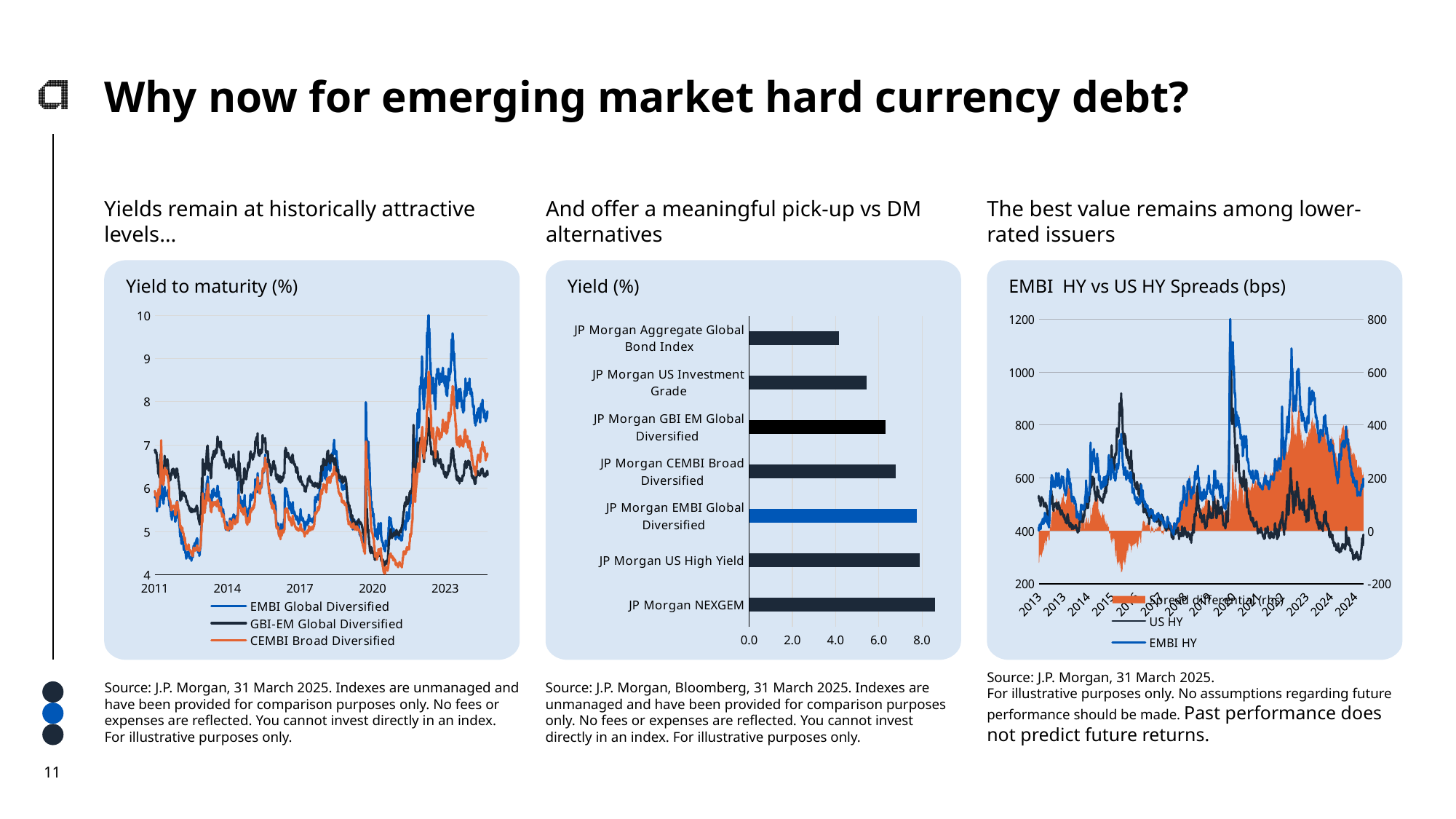
In the "Yield (%)" bar chart, how many indexes are plotted? 7 In the "Yield (%)" bar chart, which has the larger yield: JP Morgan NEXGEM or JP Morgan CEMBI Broad Diversified? JP Morgan NEXGEM How many series does the legend of the "EMBI HY vs US HY Spreads (bps)" chart list? 3 In the "Yield (%)" bar chart, which index has the lowest yield? JP Morgan Aggregate Global Bond Index In the "Yield (%)" bar chart, is the value for JP Morgan US Investment Grade greater or less than 4.0? greater How many series does the legend of the "Yield to maturity (%)" chart list? 3 In the "Yield (%)" bar chart, is the value for JP Morgan Aggregate Global Bond Index greater or less than 6.0? less What kind of chart is the "Yield to maturity (%)" chart on the left of the slide? line chart What kind of chart is the "Yield (%)" chart in the middle of the slide? bar chart In the "Yield (%)" bar chart, is the value for JP Morgan NEXGEM greater or less than 8.0? greater In the "Yield to maturity (%)" chart, which series is drawn in orange? CEMBI Broad Diversified In the "Yield (%)" bar chart, which index has the highest yield? JP Morgan NEXGEM